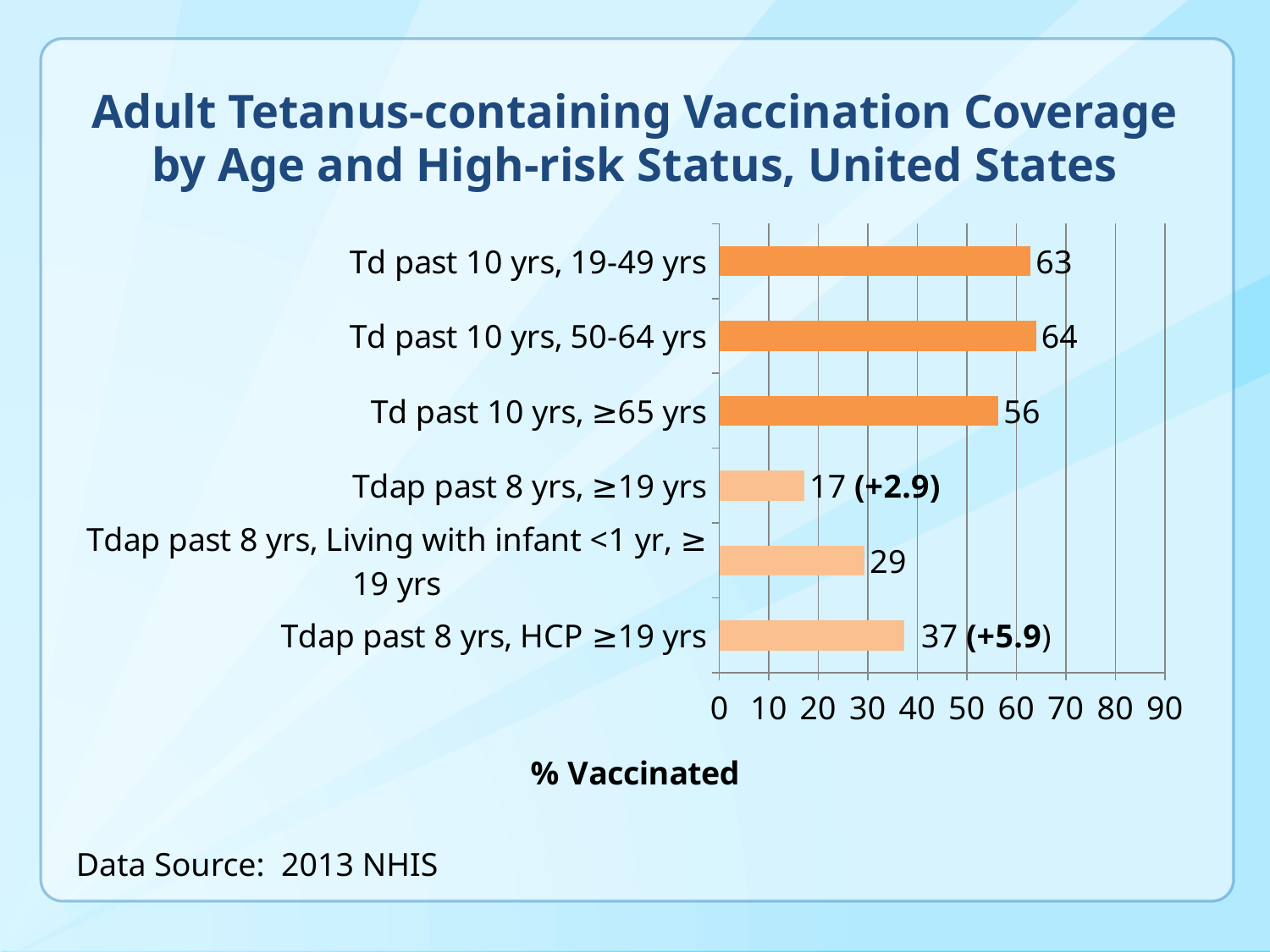
What kind of chart is shown on the slide? bar chart Which is larger: the value for Tdap past 8 yrs, HCP ≥19 yrs or the value for Tdap past 8 yrs, Living with infant <1 yr, ≥19 yrs? Tdap past 8 yrs, HCP ≥19 yrs What is the value for Td past 10 yrs, ≥65 yrs? 56 What is the value for Tdap past 8 yrs, Living with infant <1 yr, ≥19 yrs? 29 What is the label of the horizontal axis? % Vaccinated What is the value for Td past 10 yrs, 19-49 yrs? 63 Which category has the lowest value? Tdap past 8 yrs, ≥19 yrs What is the difference between the values for Td past 10 yrs, 50-64 yrs and Td past 10 yrs, ≥65 yrs? 8 Which category has the highest value? Td past 10 yrs, 50-64 yrs Is the value for Td past 10 yrs, 19-49 yrs greater or less than 50? greater How many categories are shown in the chart? 6 What is the value for Tdap past 8 yrs, HCP ≥19 yrs? 37